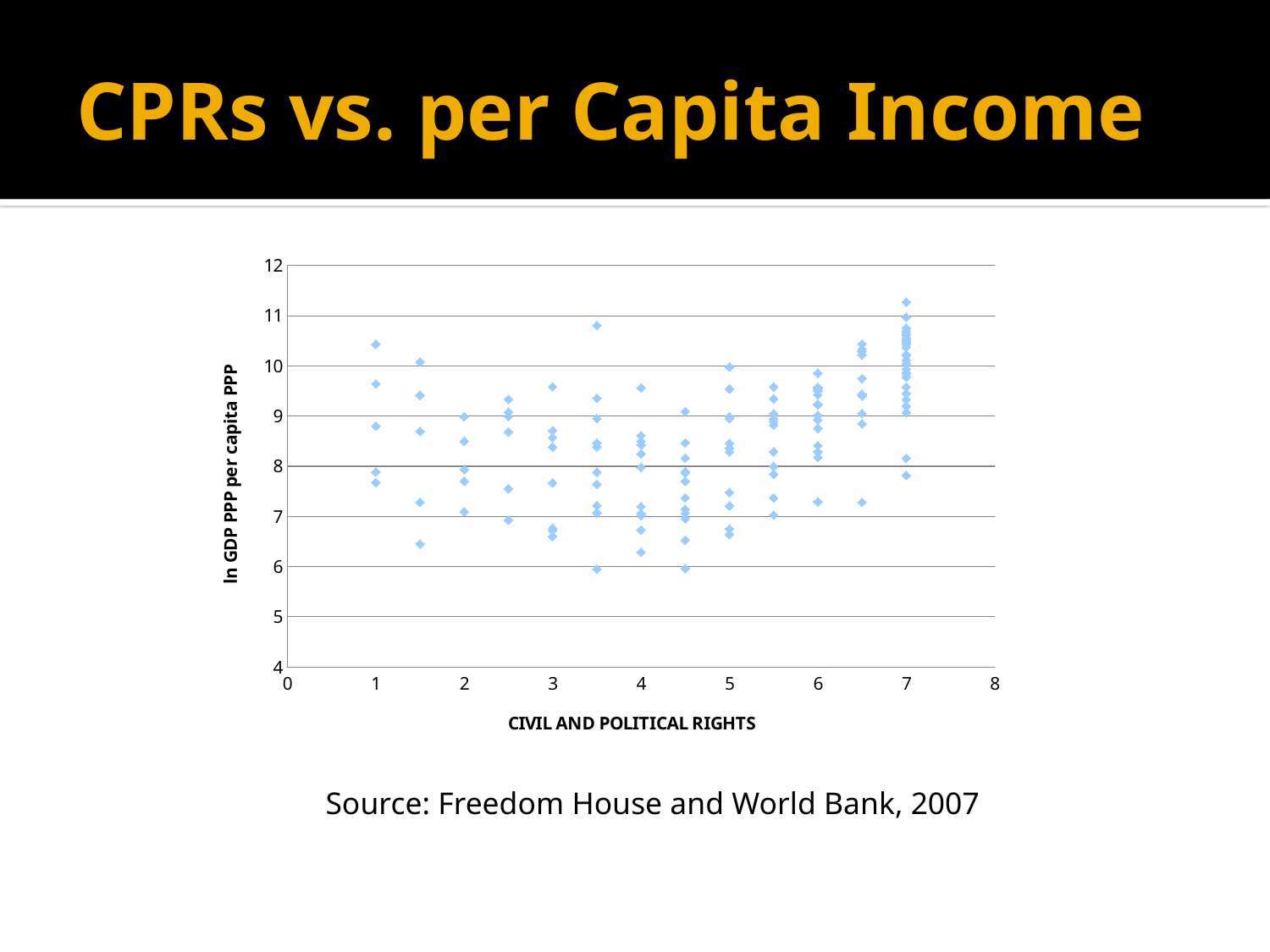
What is the highest value shown on the x axis? 8 Is the lowest point on the chart greater or less than 7? less At which x-axis value does the highest point on the chart appear? 7 What is the highest value shown on the y axis? 12 What is the lowest value shown on the y axis? 4 What kind of chart is shown on the slide? Scatter chart What is the label of the x axis? CIVIL AND POLITICAL RIGHTS Which x-axis value has the most points plotted above it? 7 Is the highest point on the chart greater or less than 11? greater What is the label of the y axis? ln GDP PPP per capita PPP Is the highest point at x = 1 greater or less than 10? greater